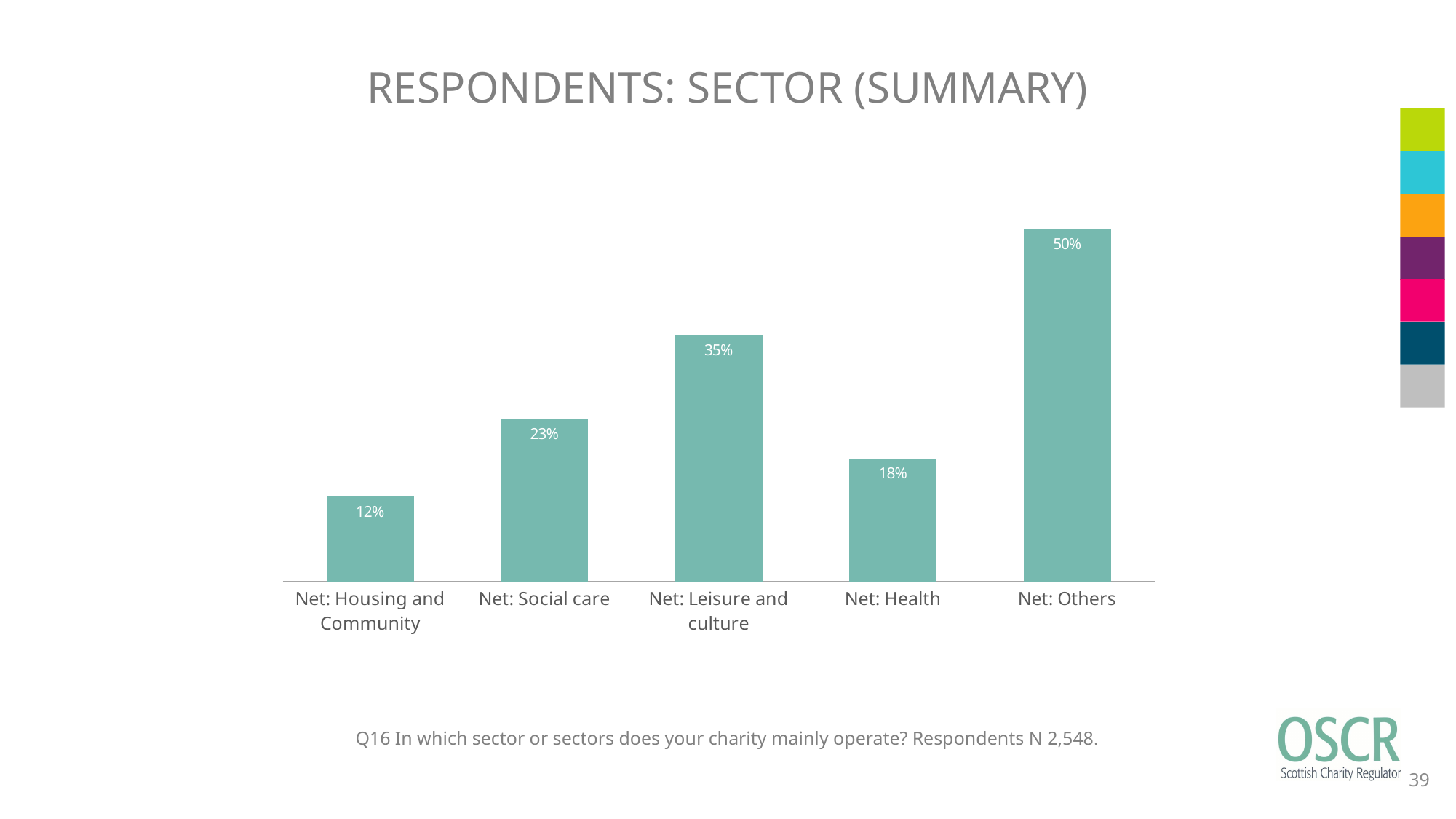
Which category has the lowest value? Net: Housing and Community Which is larger, the value for Net: Social care or the value for Net: Health? Net: Social care What is the value for Net: Social care? 23% How many categories are shown in the chart? 5 What is the value for Net: Housing and Community? 12% What is the title of the slide? RESPONDENTS: SECTOR (SUMMARY) What is the difference between the values for Net: Others and Net: Leisure and culture? 15% What kind of chart is shown on the slide? Bar chart What is the value for Net: Leisure and culture? 35% What is the value for Net: Others? 50% Which category has the highest value? Net: Others What is the value for Net: Health? 18%